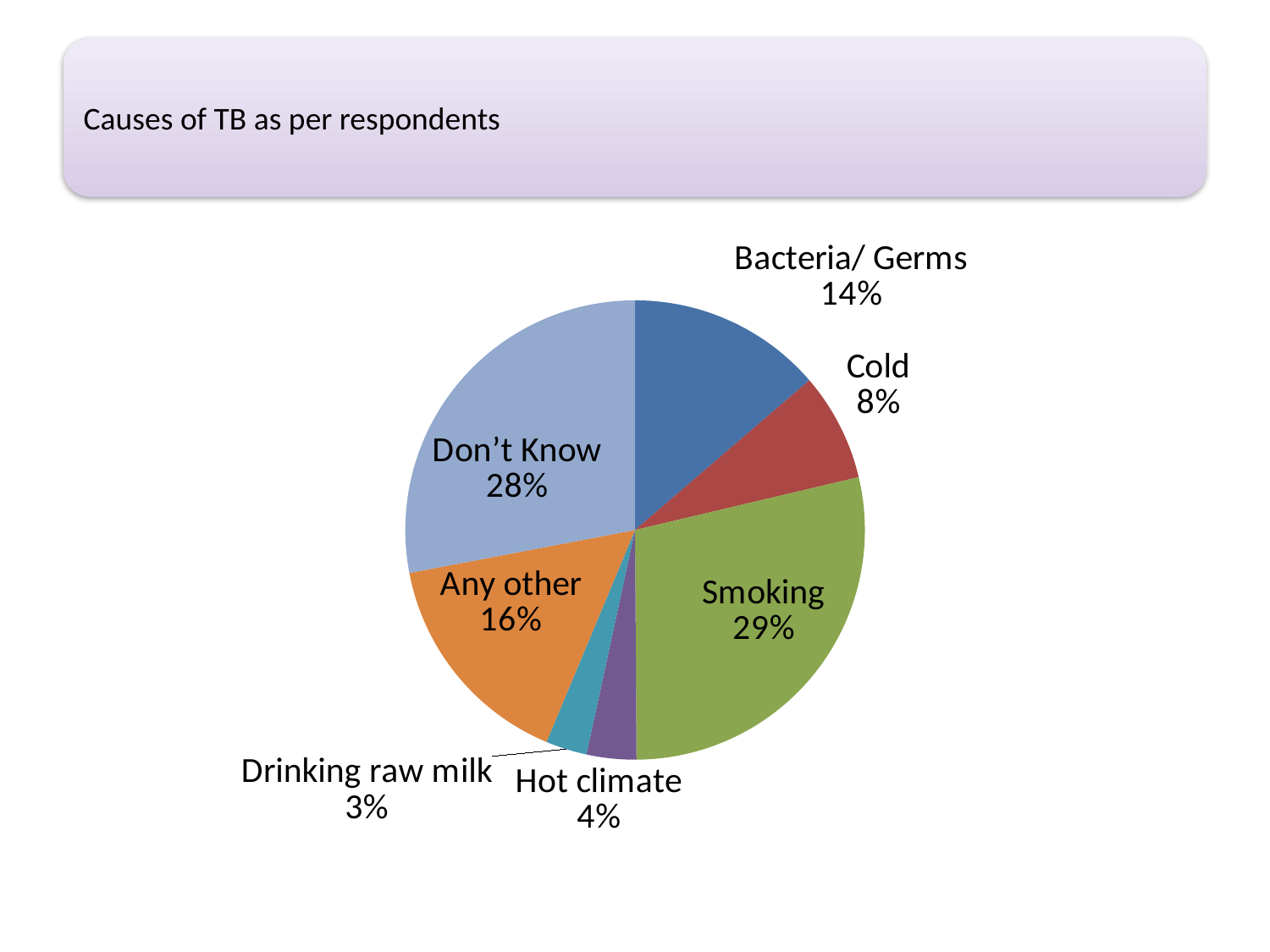
Which cause has the largest slice of the pie? Smoking Which cause has the smallest slice of the pie? Drinking raw milk What kind of chart is shown on the slide? Pie chart Which is larger, the share for Any other or the share for Cold? Any other What is the difference in percentage points between Smoking and Bacteria/ Germs? 15 What percentage of respondents cited Smoking as a cause of TB? 29% What percentage is shown for Bacteria/ Germs? 14% What share of the pie is labelled Don't Know? 28% What is the title shown at the top of the slide? Causes of TB as per respondents What percentage is shown for Drinking raw milk? 3% How many slices does the pie chart have? 7 What is the combined percentage for Cold and Hot climate? 12%